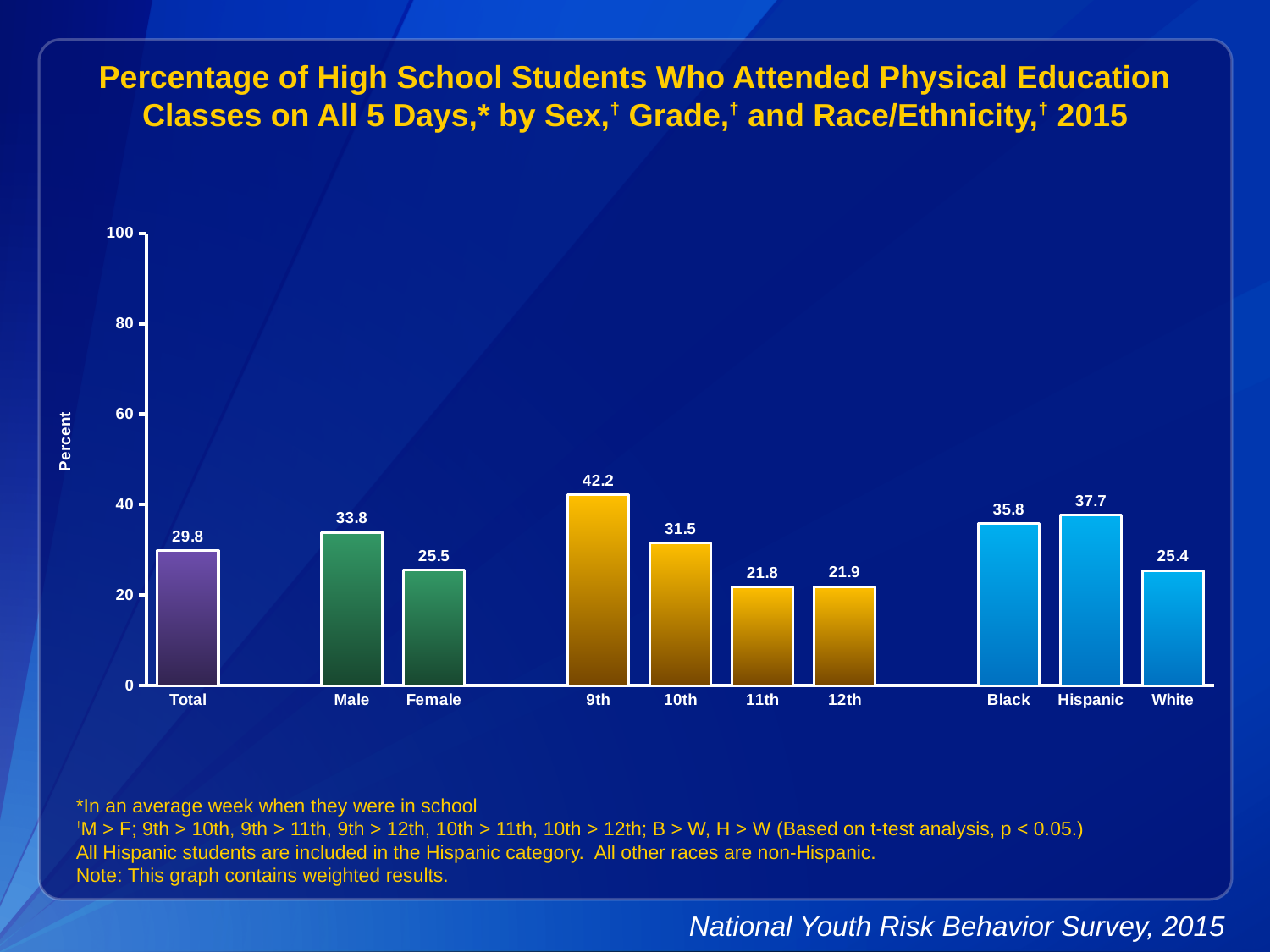
What is the value for Total? 29.8 Which category has the highest value? 9th What is the difference between the values for 9th and 12th? 20.3 Which category has the lowest value? 11th Is the value for 10th greater or less than 40? less Which is larger, the value for Black or the value for White? Black What is the value for Hispanic? 37.7 What is the label of the y axis? Percent What is the difference between the values for Male and Female? 8.3 What kind of chart is shown on the slide? bar chart What is the value for Female? 25.5 How many bars are shown in the chart? 10